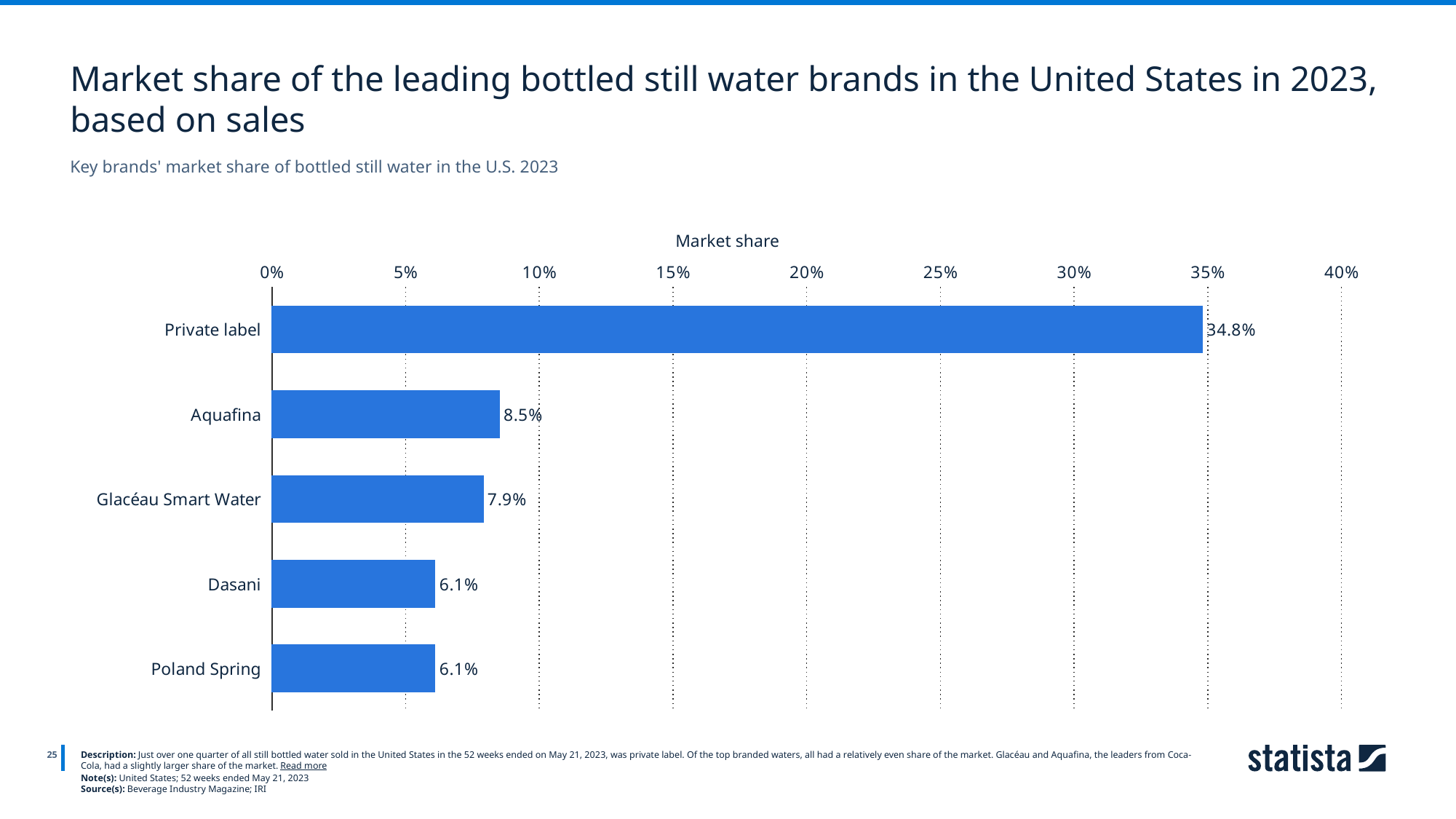
Which brand has the highest market share? Private label What is the market share of Private label? 34.8% What is the market share of Aquafina? 8.5% How many brands are shown in the chart? 5 What is the difference in market share between Private label and Aquafina? 26.3% Which has a larger market share, Aquafina or Dasani? Aquafina What is the difference in market share between Aquafina and Glacéau Smart Water? 0.6% What is the market share of Glacéau Smart Water? 7.9% What kind of chart is shown on the slide? Bar chart What is the title of the chart's axis showing the values? Market share What is the market share of Dasani? 6.1% Is the market share of Private label greater or less than 30%? greater